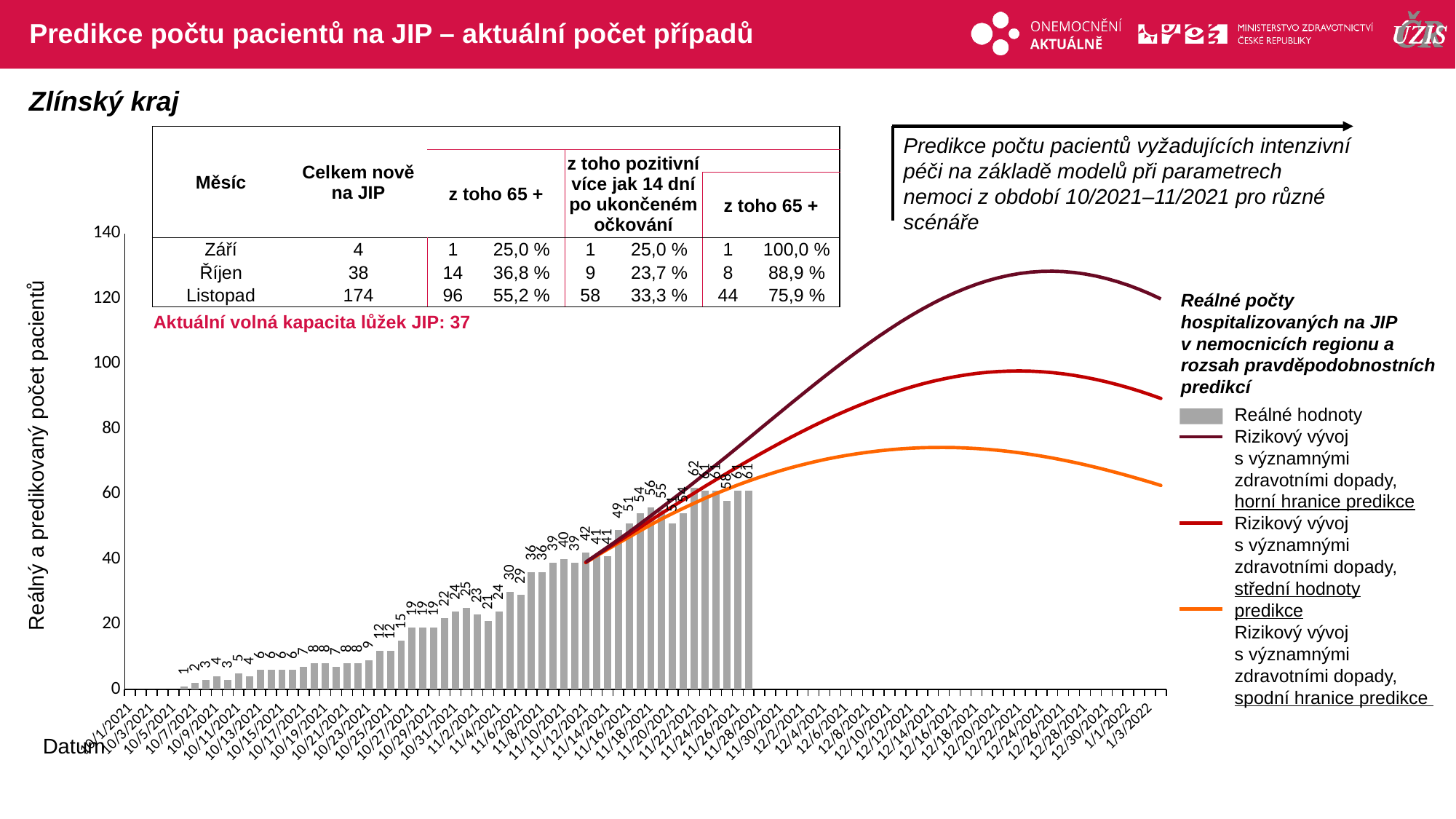
Is the peak of the upper prediction line (horní hranice predikce) greater or less than 120? greater What is the highest tick value shown on the y axis? 140 How many series does the chart legend list? 4 Do the real values (grey bars) rise or fall from October to late November 2021? Rise What is the value labelled on the last grey bar in the chart? 61 Is the peak of the lower prediction line (spodní hranice predikce) greater or less than 60? greater At the end of the prediction period (1/3/2022), which line is higher: the upper bound (horní hranice predikce) or the lower bound (spodní hranice predikce)? Horní hranice predikce What is the lowest value labelled on the grey bars (Reálné hodnoty)? 1 What kind of chart is shown on the slide? A combined bar and line chart What is the highest value labelled on the grey bars (Reálné hodnoty)? 62 Which legend entry corresponds to the grey bars? Reálné hodnoty Is the peak of the lower prediction line (spodní hranice predikce) greater or less than 80? less